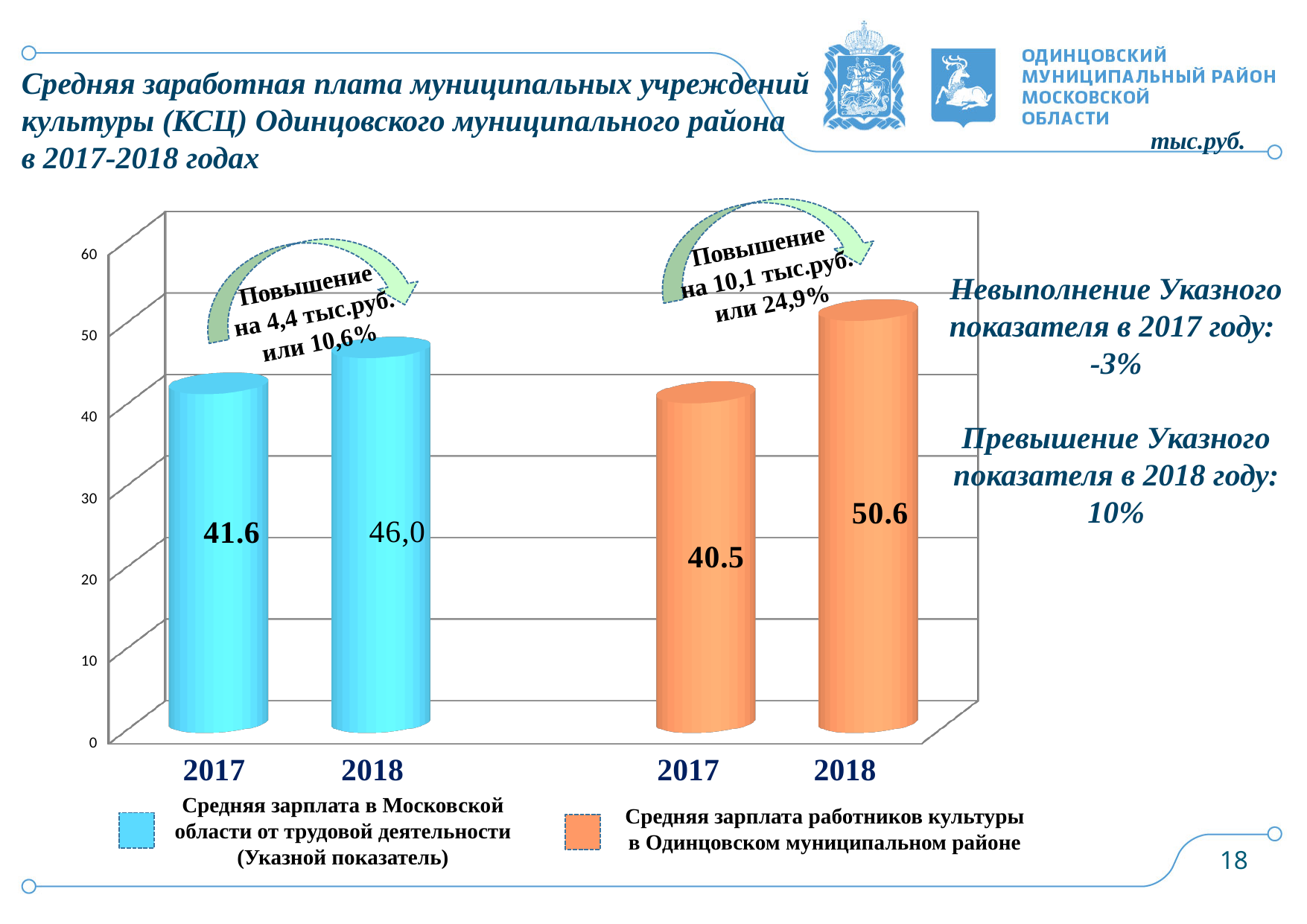
What is the average salary in the Moscow region (Указной показатель) in 2018? 46,0 What is the average salary of culture workers in the Odintsovo municipal district in 2017? 40.5 How many series does the legend list? 2 How many bars are plotted on the chart? 4 What type of chart is shown on the slide? Bar chart In 2017, which is larger: the Moscow region average salary or the Odintsovo culture workers' salary? Moscow region average salary (41.6) Which bar has the highest value on the chart? Culture workers in Odintsovo district, 2018 (50.6) What is the average salary of culture workers in the Odintsovo municipal district in 2018? 50.6 Is the 2018 value for culture workers in the Odintsovo district greater or less than 50? greater What is the average salary in the Moscow region (Указной показатель) in 2017? 41.6 Which bar has the lowest value on the chart? Culture workers in Odintsovo district, 2017 (40.5) What is the difference between the 2018 and 2017 values for culture workers in the Odintsovo municipal district? 10.1